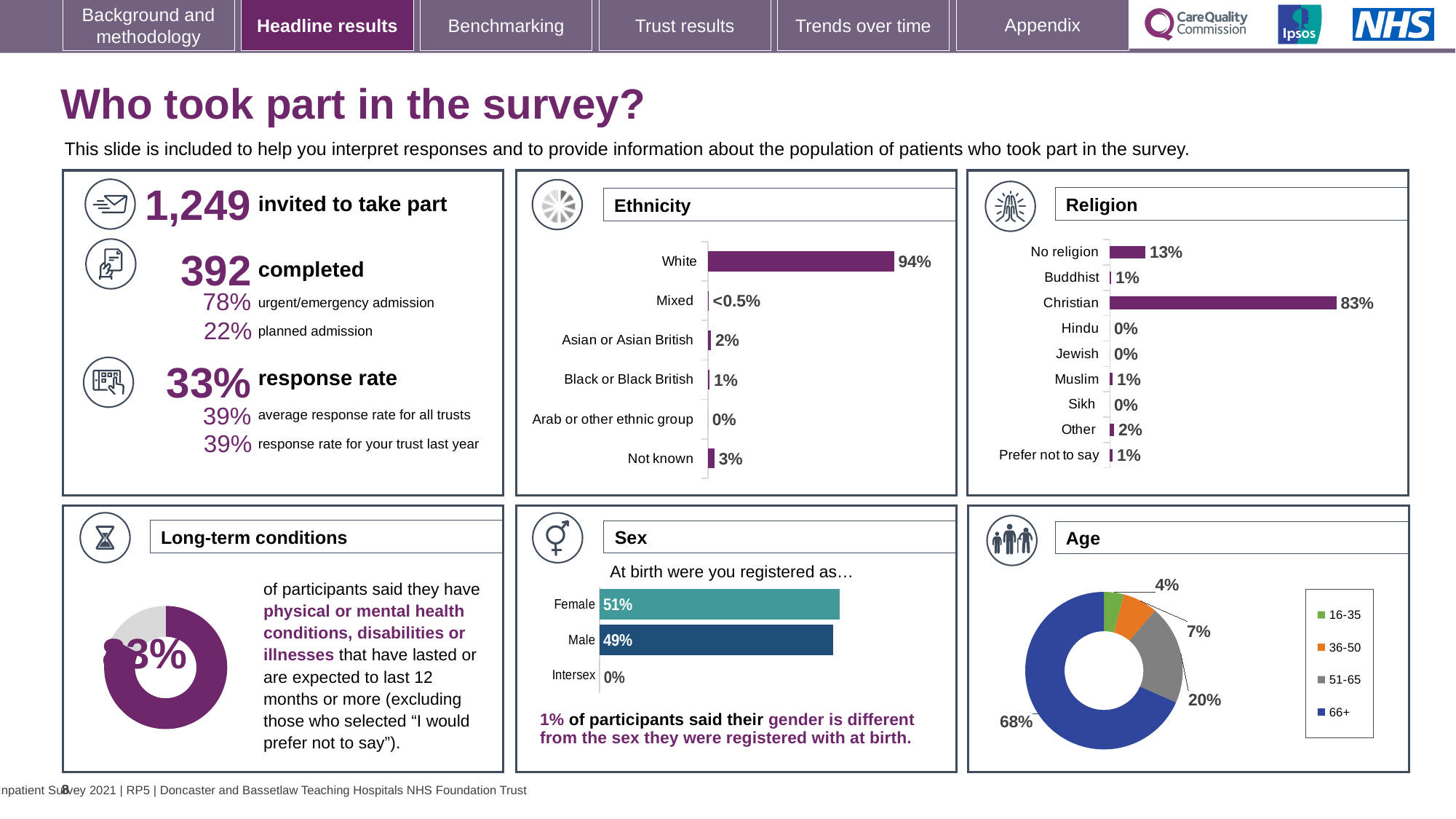
In the Religion chart, what is the value for No religion? 13% In the Ethnicity chart, which ethnic group has the highest percentage? White In the Ethnicity chart, what is the value for Not known? 3% In the Age chart, what share of participants were aged 66+? 68% What kind of chart is the Age chart? Doughnut chart In the Religion chart, how many religion categories are listed? 9 In the Sex chart, which is larger, the Female value or the Male value? Female In the Religion chart, what percentage of participants were Christian? 83% In the Religion chart, what is the difference between the Christian and No religion values? 70% In the Ethnicity chart, how many ethnic group categories are shown? 6 In the Ethnicity chart, what percentage of participants were White? 94% In the Sex chart, what percentage of participants were registered as Female at birth? 51%